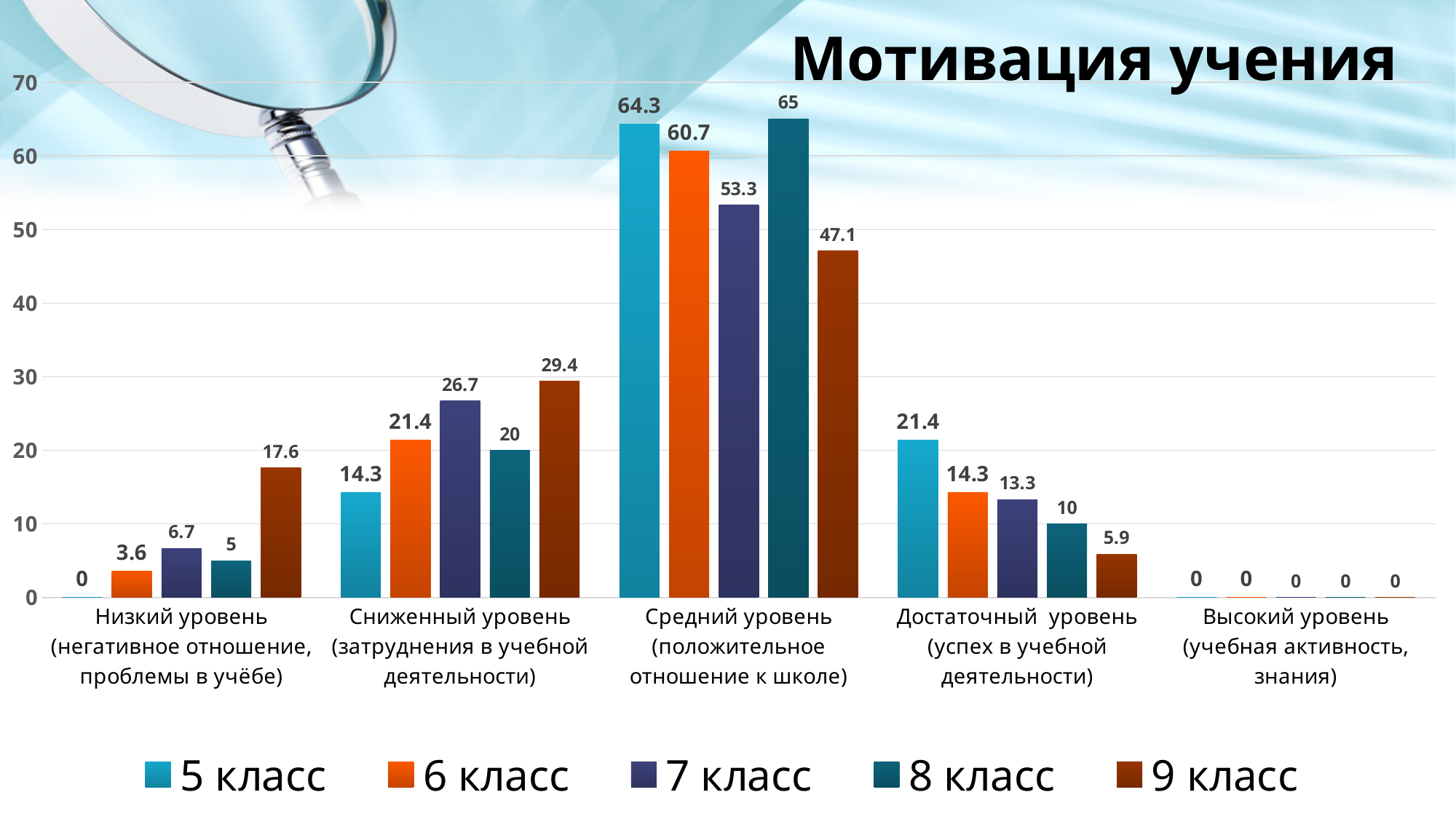
What is the difference between the 9 класс and 8 класс values in the Сниженный уровень category? 9.4 Which class has the lowest value in the Достаточный уровень category? 9 класс How many series does the legend list? 5 What is the title of the slide? Мотивация учения What is the value for 9 класс in the Низкий уровень category? 17.6 Is the value for 9 класс in the Средний уровень category greater or less than 50? less What is the value for 8 класс in the Достаточный уровень category? 10 How many categories are shown on the x axis? 5 Which class has the highest value in the Средний уровень category? 8 класс What kind of chart is shown on the slide? bar chart Which is larger in the Низкий уровень category: the value for 7 класс or for 8 класс? 7 класс What is the value for 5 класс in the Средний уровень category? 64.3